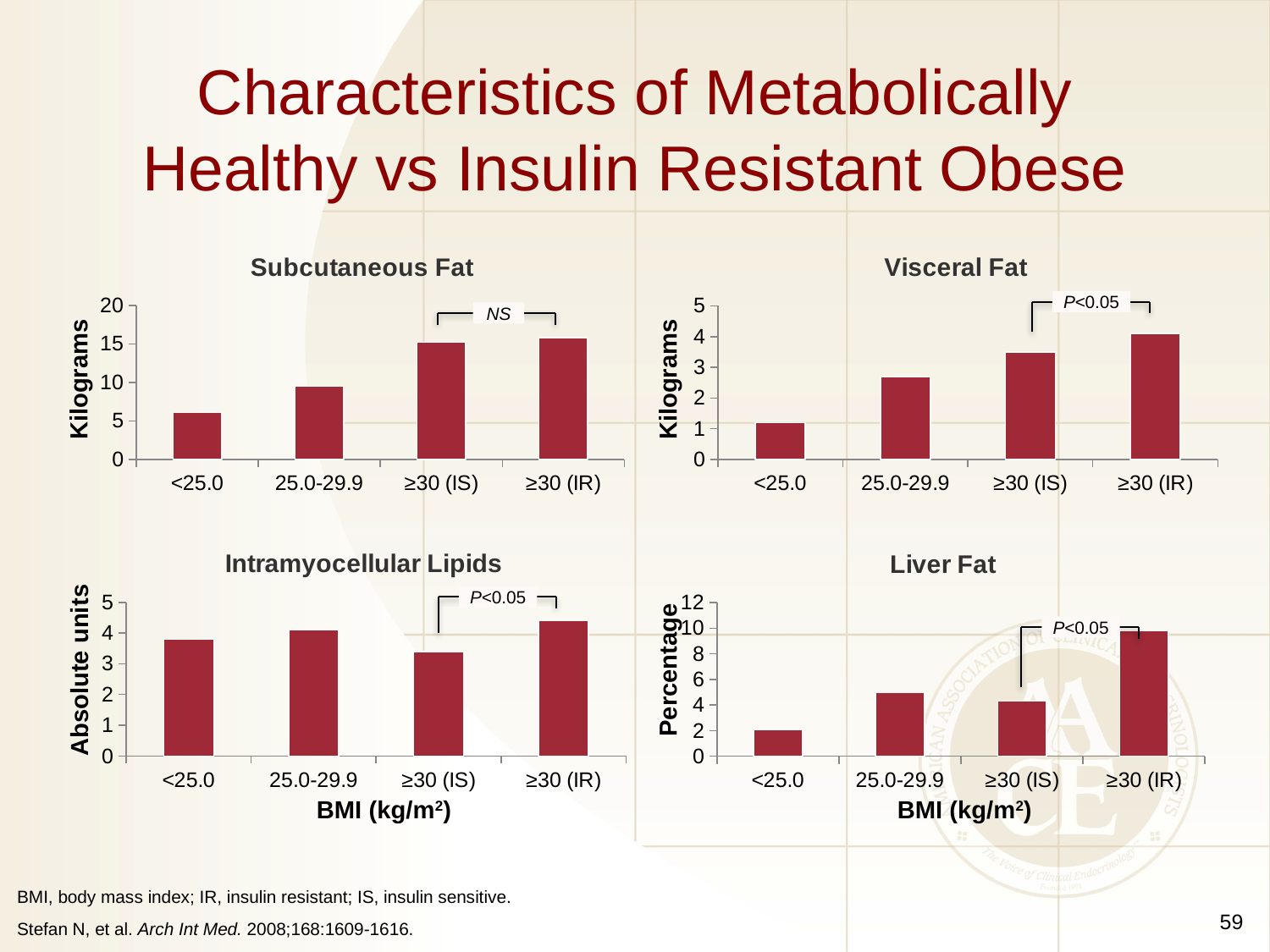
On the Subcutaneous Fat chart, is the value for <25.0 greater or less than 10? less What is the y-axis label of the Liver Fat chart? Percentage What kind of chart is the Subcutaneous Fat chart? bar chart On the Liver Fat chart, is the value for ≥30 (IR) greater or less than 8? greater On the Visceral Fat chart, which BMI category has the highest value? ≥30 (IR) On the Visceral Fat chart, do the values rise or fall from <25.0 to ≥30 (IR)? rise On the Intramyocellular Lipids chart, which BMI category has the lowest value? ≥30 (IS) On the Liver Fat chart, which is larger, the value for 25.0-29.9 or the value for ≥30 (IS)? 25.0-29.9 On the Visceral Fat chart, is the value for <25.0 greater or less than 2? less On the Liver Fat chart, which BMI category has the lowest value? <25.0 How many BMI categories are shown on the Visceral Fat chart? 4